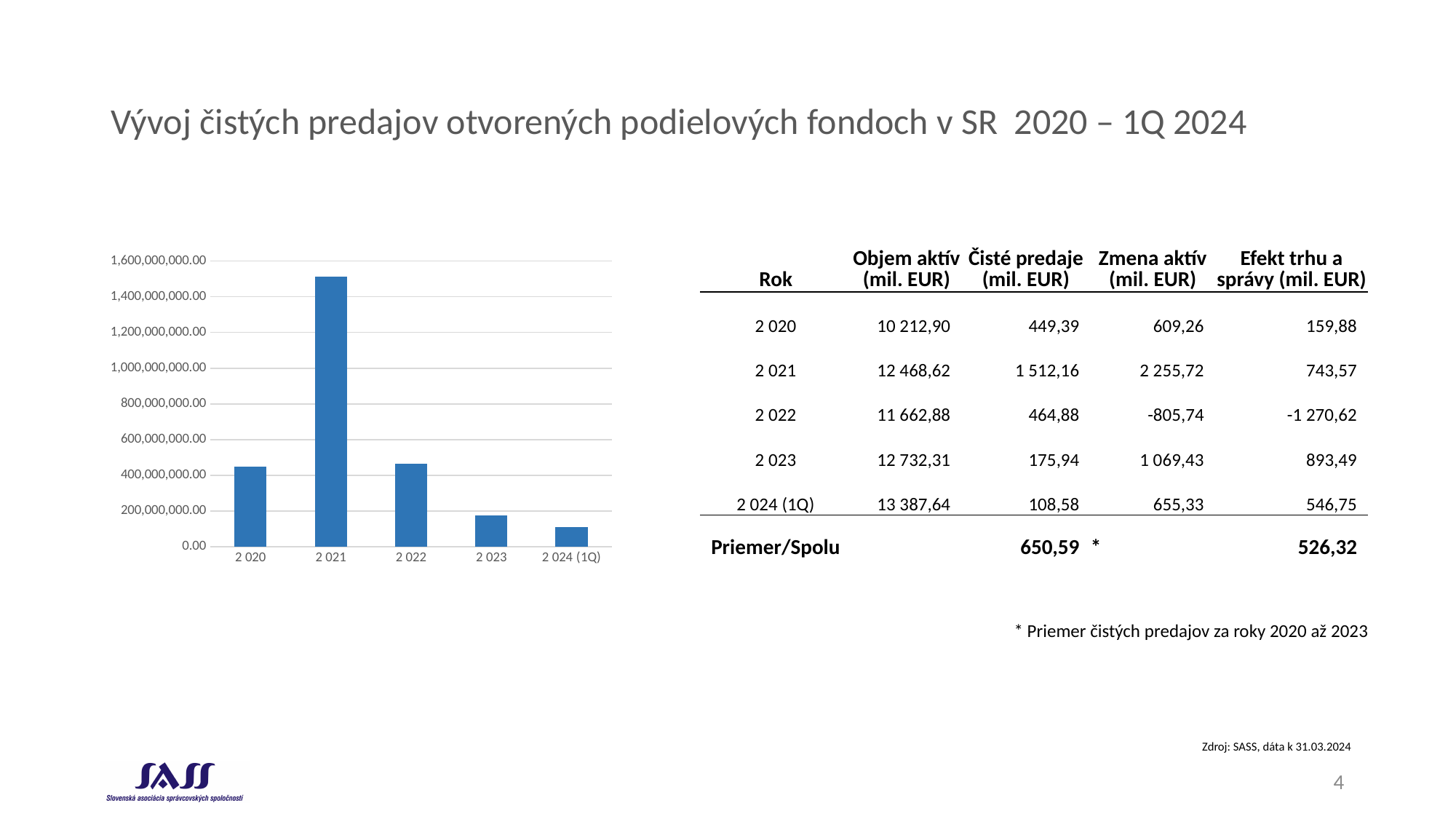
Is the value for 2 020 greater or less than 600,000,000.00? less Is the value for 2 024 (1Q) greater or less than 200,000,000.00? less How many bars (categories) does the chart show? 5 What kind of chart is shown on the slide? bar chart Is the value for 2 022 greater or less than 800,000,000.00? less Which category has the lowest bar in the chart? 2 024 (1Q) Do the values in the chart rise or fall from 2 021 to 2 024 (1Q)? fall What is the highest value shown on the chart's vertical axis? 1,600,000,000.00 Which is larger in the chart, the value for 2 023 or the value for 2 024 (1Q)? 2 023 Which category has the highest bar in the chart? 2 021 Which is larger in the chart, the value for 2 021 or the value for 2 022? 2 021